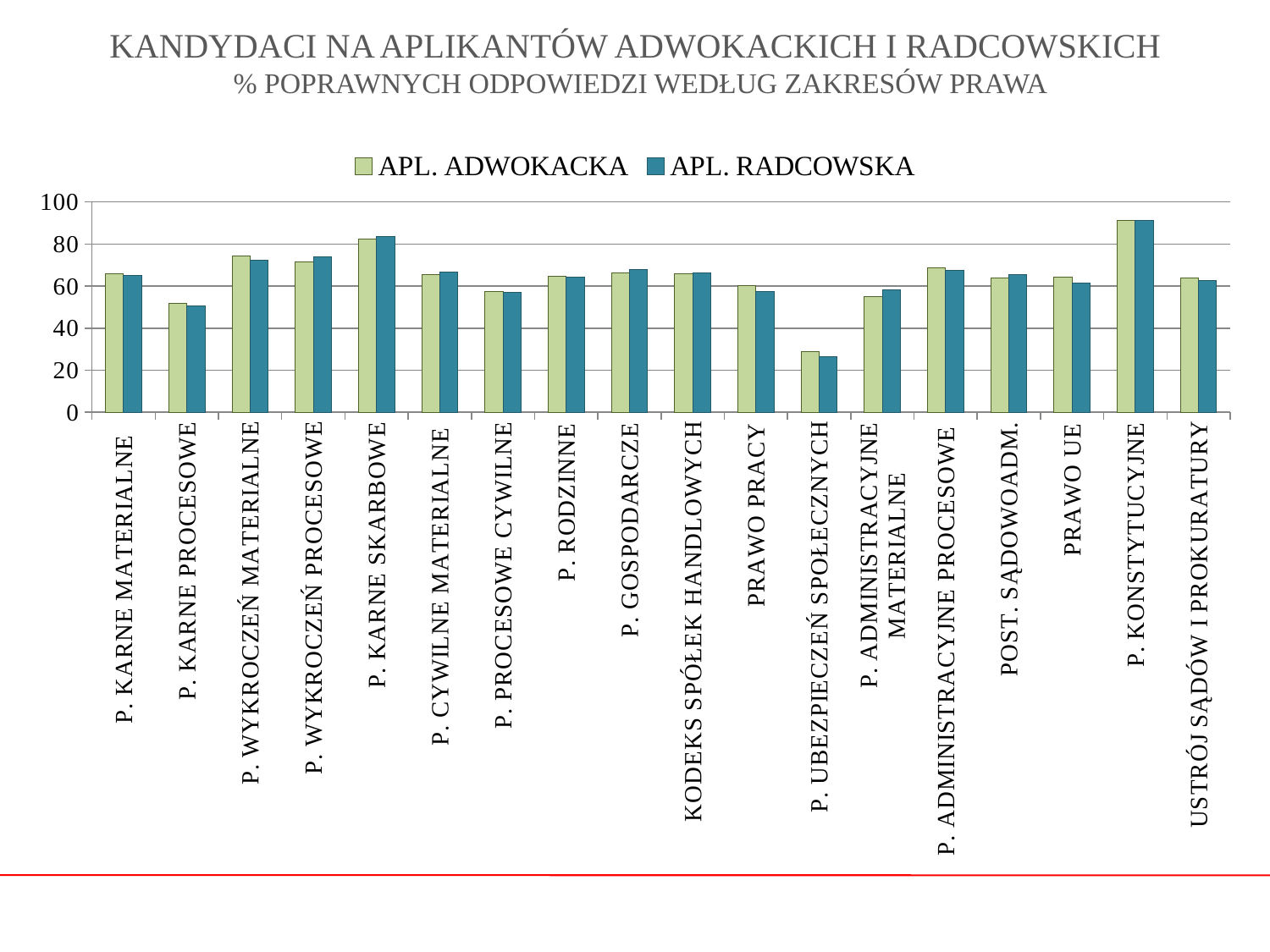
What are the two series named in the legend? APL. ADWOKACKA and APL. RADCOWSKA Which category has the lowest value for APL. RADCOWSKA? P. UBEZPIECZEŃ SPOŁECZNYCH Is the APL. RADCOWSKA value for P. UBEZPIECZEŃ SPOŁECZNYCH greater or less than 40? less For APL. ADWOKACKA, which is larger: P. KARNE PROCESOWE or P. UBEZPIECZEŃ SPOŁECZNYCH? P. KARNE PROCESOWE Which category has the highest value for APL. ADWOKACKA? P. KONSTYTUCYJNE Is the APL. ADWOKACKA value for P. ADMINISTRACYJNE MATERIALNE greater or less than 60? less How many categories (areas of law) are shown on the x axis? 18 What kind of chart is shown on the slide? bar chart How many series does the legend list? 2 For APL. RADCOWSKA, which is larger: P. KARNE SKARBOWE or P. RODZINNE? P. KARNE SKARBOWE Is the APL. ADWOKACKA value for P. KONSTYTUCYJNE greater or less than 80? greater